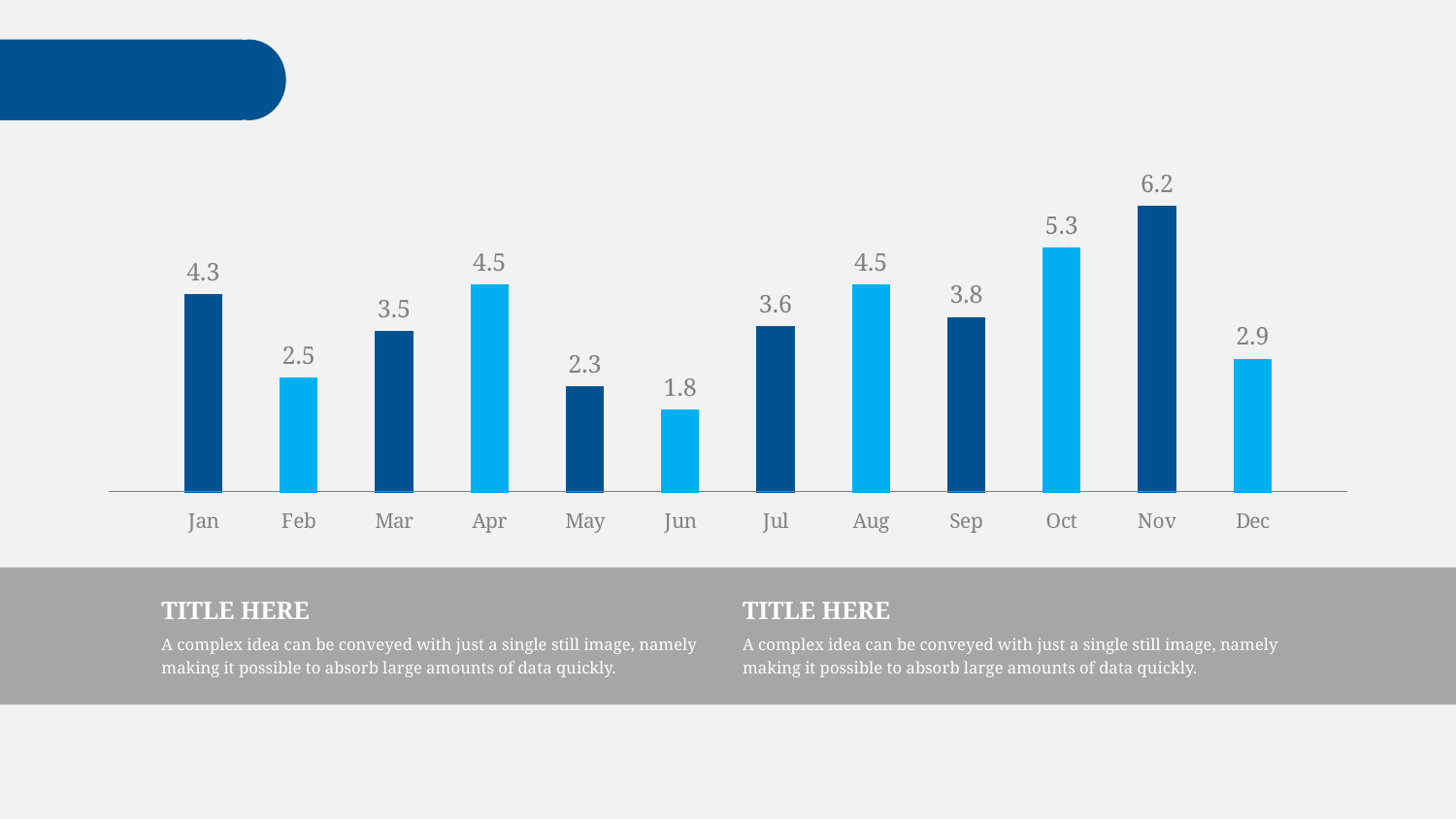
What is the difference between the values for Nov and Jun? 4.4 Which month has the highest value? Nov Which is larger, the value for Jan or the value for Mar? Jan What is the value for Nov? 6.2 Which month has the lowest value? Jun What is the value for Oct? 5.3 What is the difference between the values for Oct and Sep? 1.5 What is the value for Jun? 1.8 How many months are shown on the x axis? 12 Which is larger, the value for Feb or the value for Dec? Dec What kind of chart is shown on the slide? bar chart